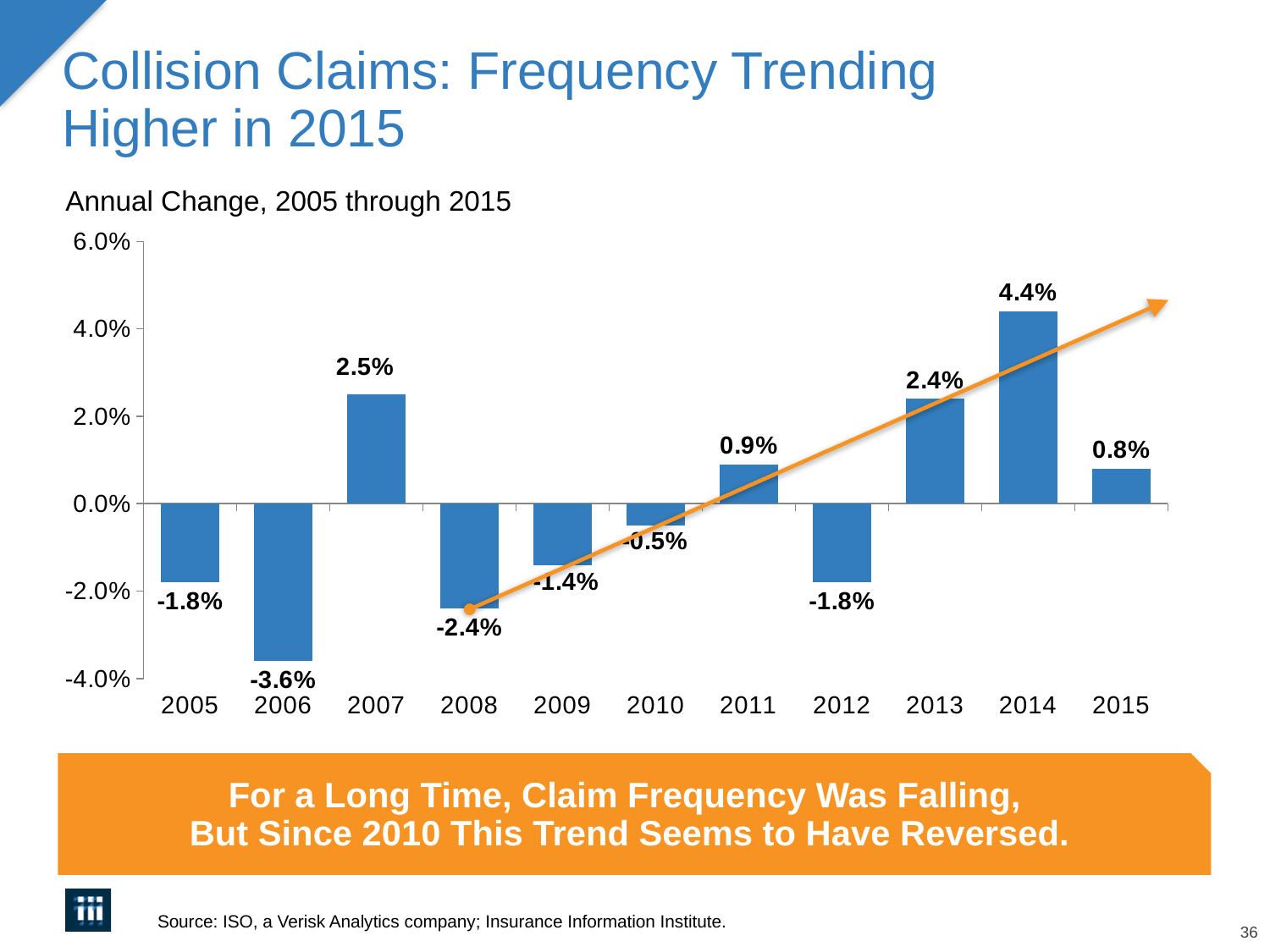
What kind of chart is used to show the annual change in collision claim frequency? Bar chart What is the annual change in collision claim frequency for 2015? 0.8% Which year has the highest annual change in collision claim frequency? 2014 Which two years both show an annual change of -1.8%? 2005 and 2012 What is the annual change in collision claim frequency for 2014? 4.4% Which year has the lowest annual change in collision claim frequency? 2006 What is the annual change in collision claim frequency for 2006? -3.6% What is the difference between the annual change in 2014 and the annual change in 2013? 2.0% How many years are shown on the x axis of the chart? 11 Which year has the larger annual change, 2007 or 2011? 2007 From 2012 to 2014, do the annual change values rise or fall? Rise What is the subtitle printed above the chart? Annual Change, 2005 through 2015